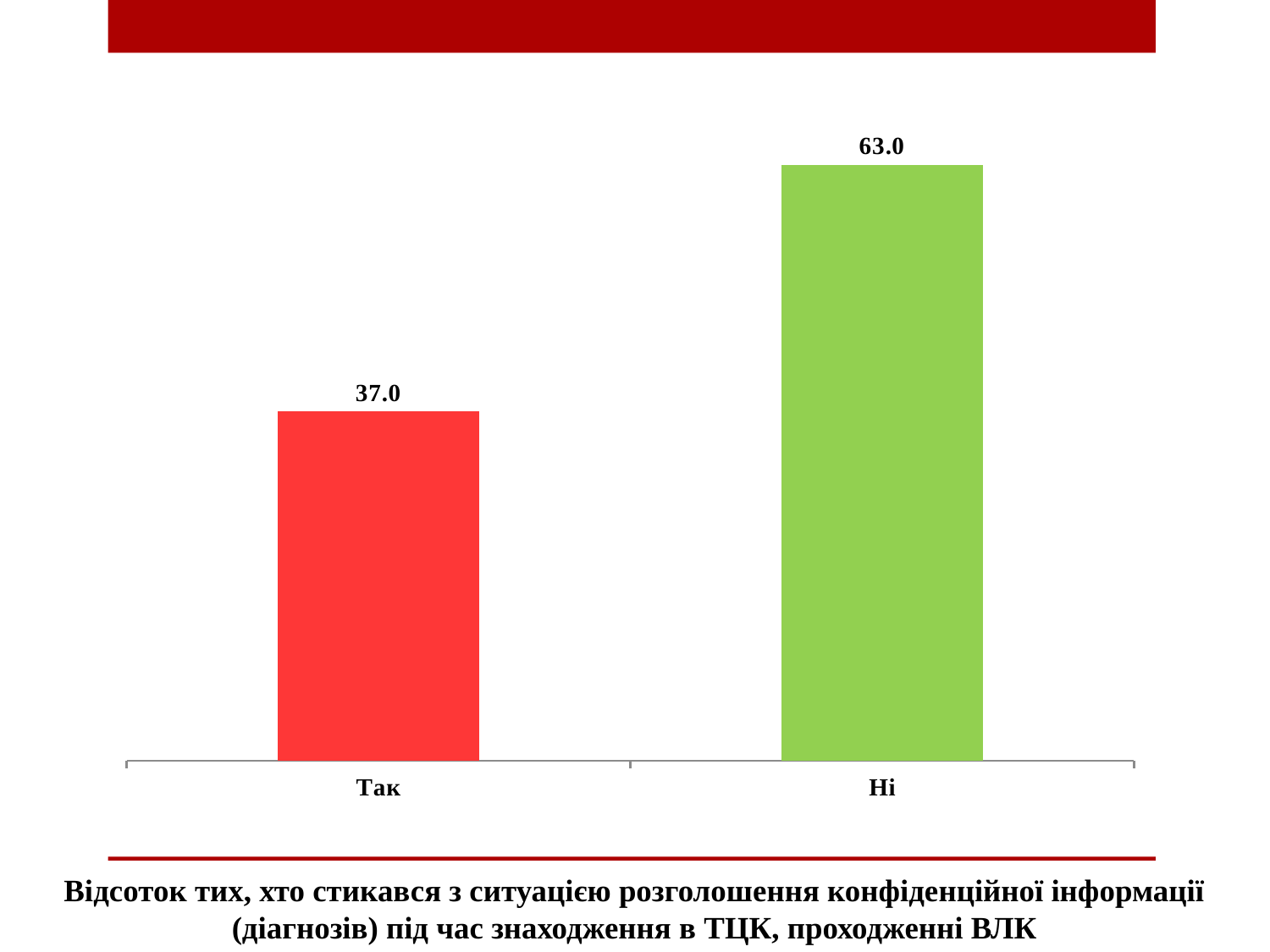
What kind of chart is shown on the slide? Bar chart How many categories are shown on the chart? 2 What is the value for "Так"? 37.0 What colour is the bar for "Так"? Red Which category has the lowest value? Так What is the total of the two bar values? 100.0 Which is larger, the value for "Так" or the value for "Ні"? Ні What is the value for "Ні"? 63.0 Which category has the highest value? Ні What colour is the bar for "Ні"? Green What is the difference between the values for "Ні" and "Так"? 26.0